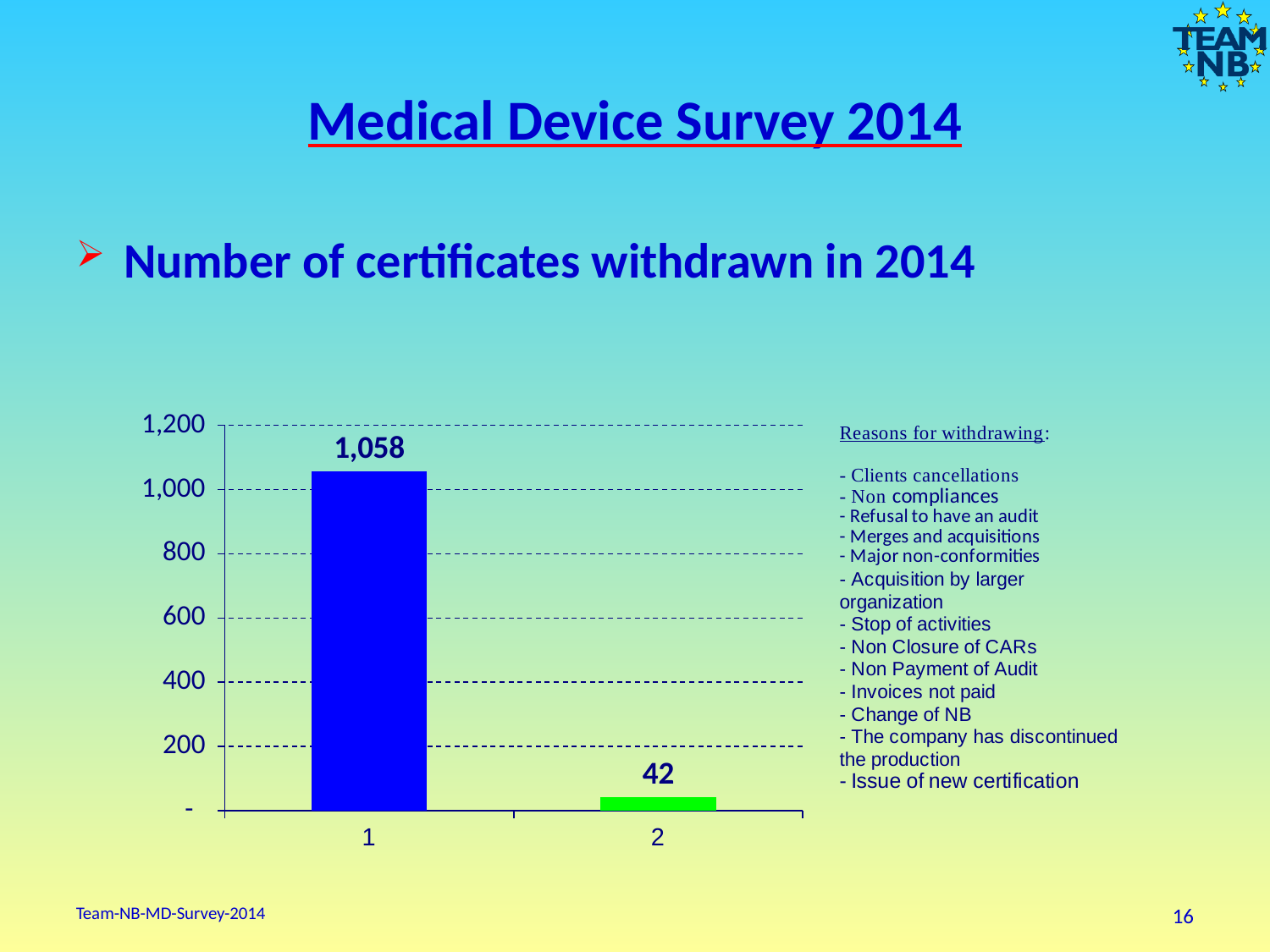
Do the values rise or fall from category 1 to category 2? fall Which category has the highest value? 1 What is the difference between the values for category 1 and category 2? 1,016 What colour is the bar for category 2? green What is the value for category 1? 1,058 Is the value for category 1 greater or less than 1,000? greater Which is larger, the value for category 1 or category 2? category 1 Is the value for category 2 greater or less than 200? less How many categories are shown on the x axis? 2 What kind of chart is shown on the slide? bar chart What is the value for category 2? 42 Which category has the lowest value? 2